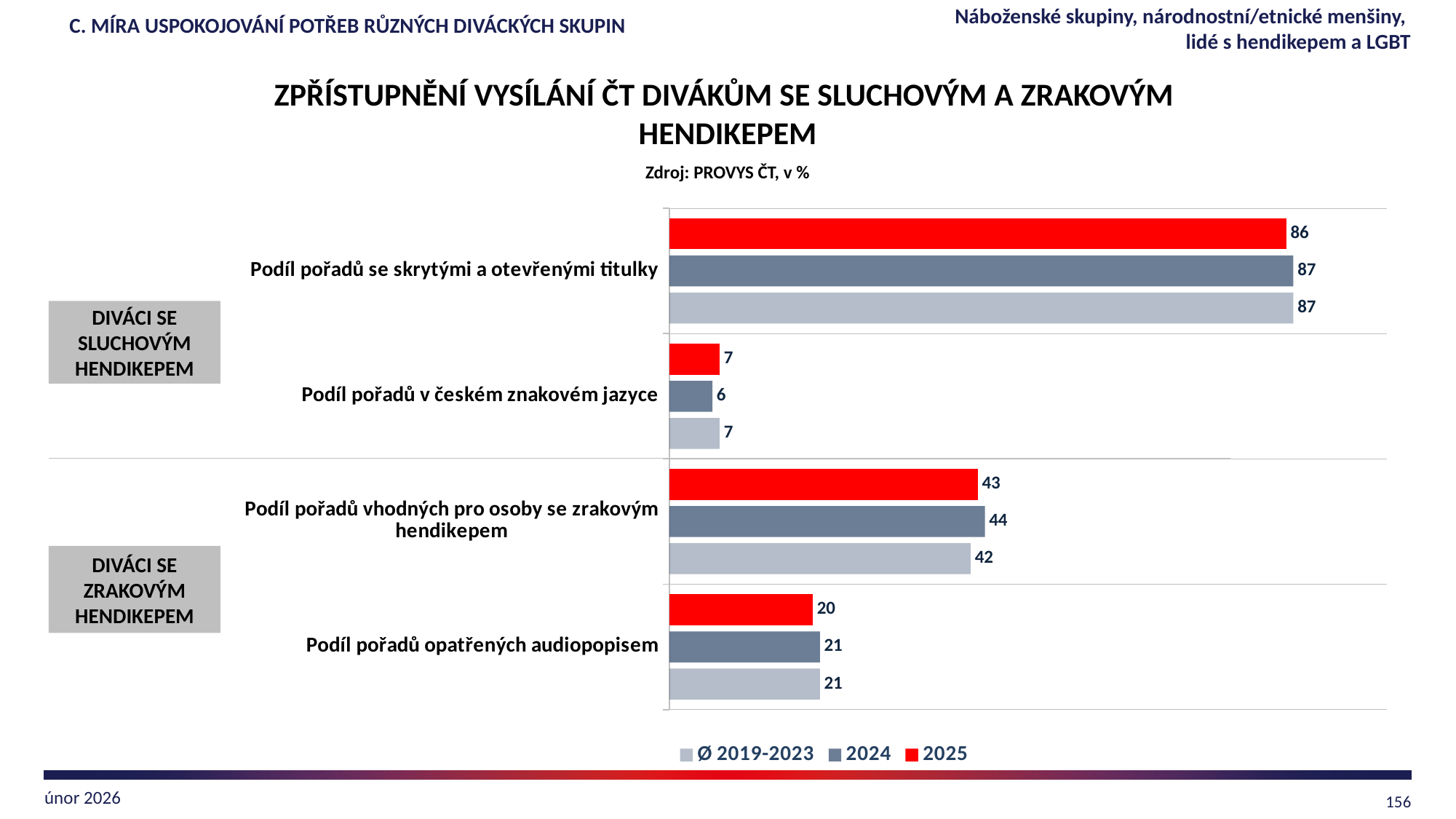
What is the 2025 value for "Podíl pořadů opatřených audiopopisem"? 20 How many categories are shown in the chart? 4 Which is larger for "Podíl pořadů vhodných pro osoby se zrakovým hendikepem": the 2024 value or the Ø 2019-2023 value? 2024 What is the difference between the 2024 and 2025 values for "Podíl pořadů se skrytými a otevřenými titulky"? 1 How many series does the legend list? 3 Which series is shown in red in the chart? 2025 What is the 2025 value for "Podíl pořadů se skrytými a otevřenými titulky"? 86 Which category has the highest 2025 value? Podíl pořadů se skrytými a otevřenými titulky What is the Ø 2019-2023 value for "Podíl pořadů vhodných pro osoby se zrakovým hendikepem"? 42 Which category has the lowest 2024 value? Podíl pořadů v českém znakovém jazyce What kind of chart is shown on the slide? Bar chart What is the 2024 value for "Podíl pořadů v českém znakovém jazyce"? 6